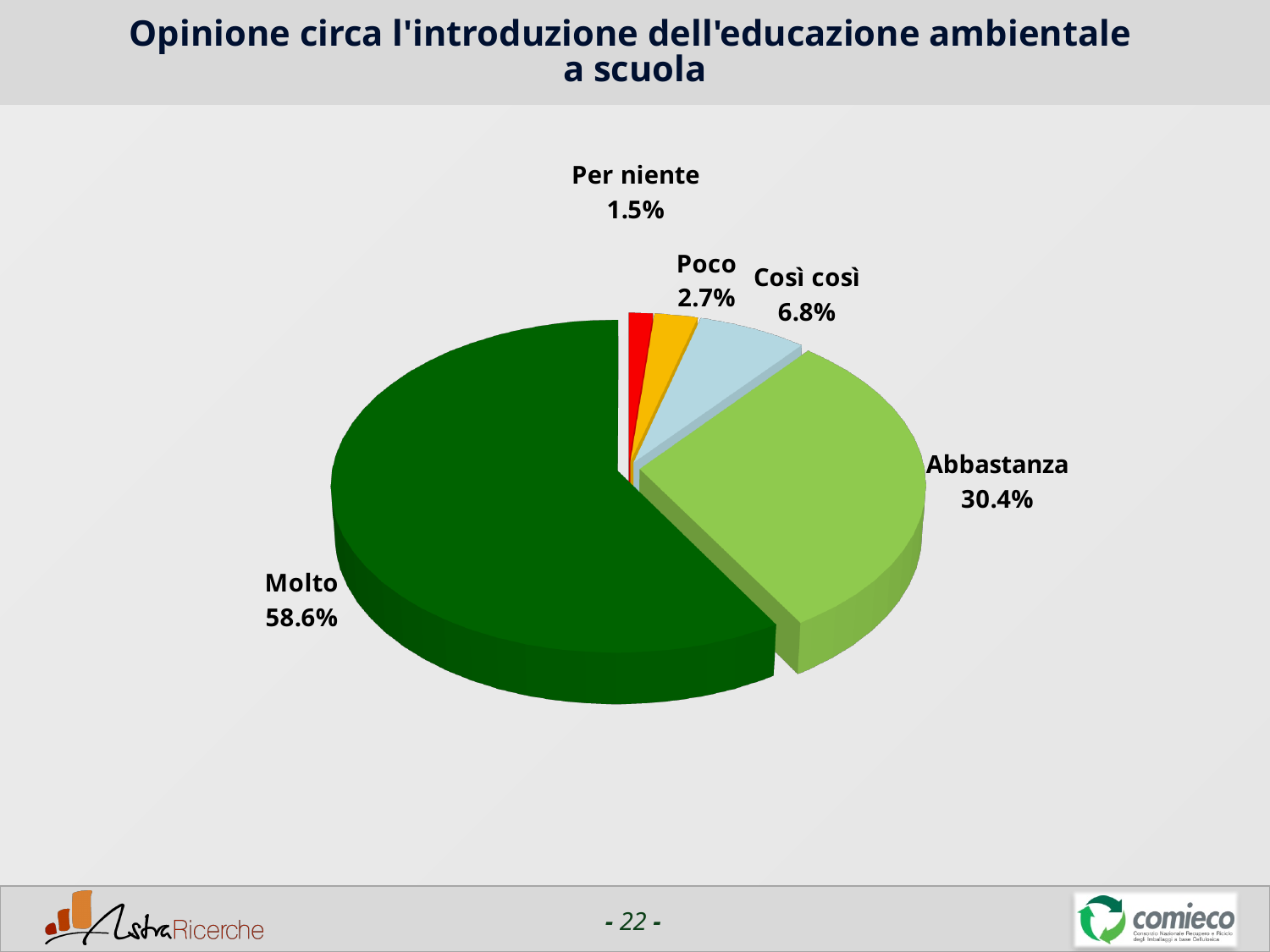
What type of chart is shown on the slide? pie chart Which category has the largest share of the pie? Molto Which is larger, the value for Così così or the value for Poco? Così così What is the value for Molto? 58.6% What is the title of the chart? Opinione circa l'introduzione dell'educazione ambientale a scuola What is the value for Per niente? 1.5% What is the value for Così così? 6.8% Which category has the smallest share of the pie? Per niente What is the value for Poco? 2.7% How many categories are shown in the pie chart? 5 What is the value for Abbastanza? 30.4% What is the difference between the values for Molto and Abbastanza? 28.2%